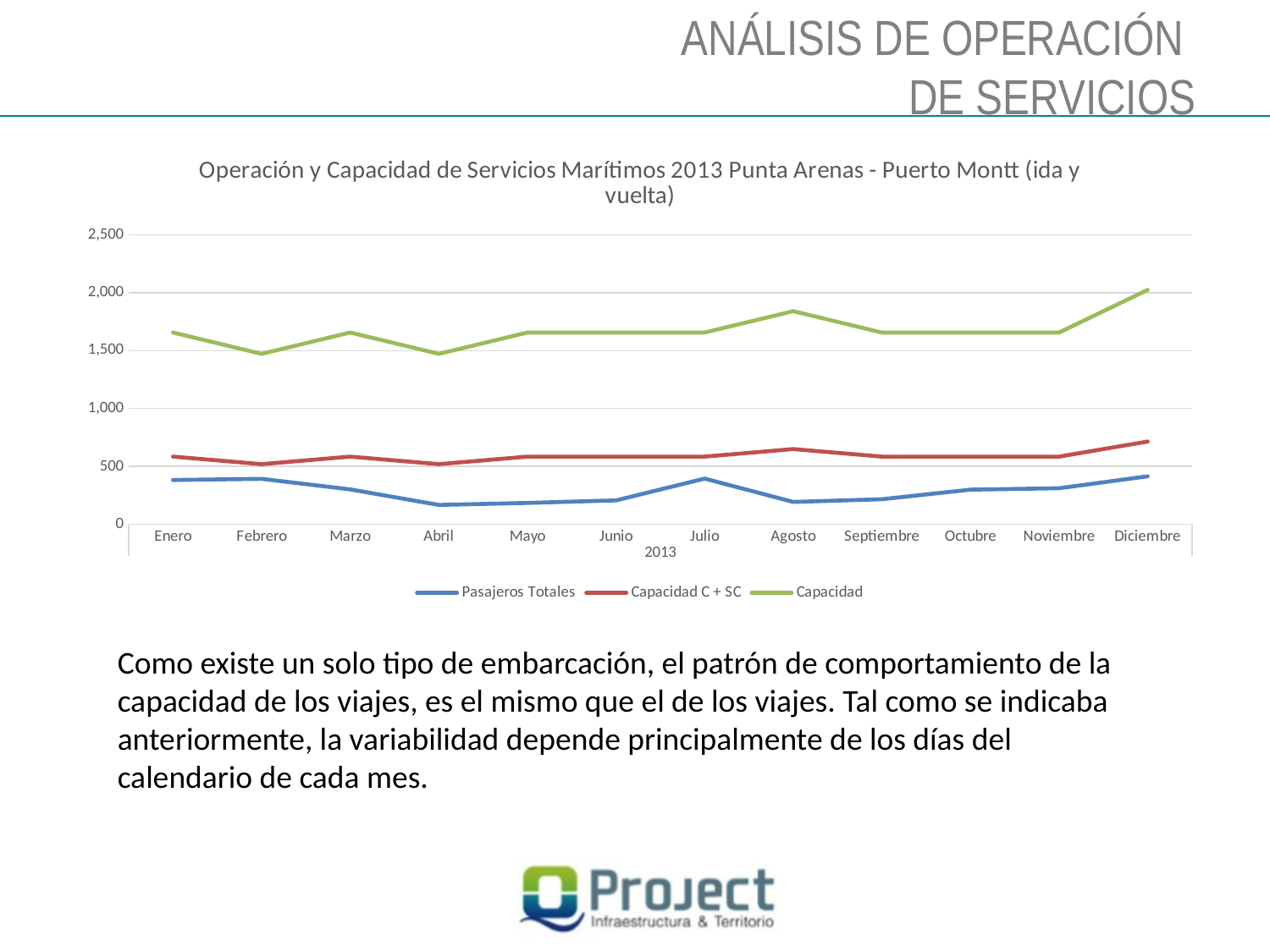
Which is larger in Agosto: Capacidad or Pasajeros Totales? Capacidad Is the value of Pasajeros Totales in Abril greater or less than 500? less In which month is the Capacidad C + SC series highest? Diciembre What kind of chart is shown on the slide? Line chart Is the value of Capacidad in Agosto greater or less than 1,500? greater Which series is drawn in green? Capacidad Is the value of Capacidad C + SC in Diciembre greater or less than 500? greater What is the title of the chart? Operación y Capacidad de Servicios Marítimos 2013 Punta Arenas - Puerto Montt (ida y vuelta) How many months are plotted along the x axis? 12 How many series does the legend list? 3 Does the Pasajeros Totales series rise or fall from Febrero to Abril? Fall In which month is the Capacidad series highest? Diciembre